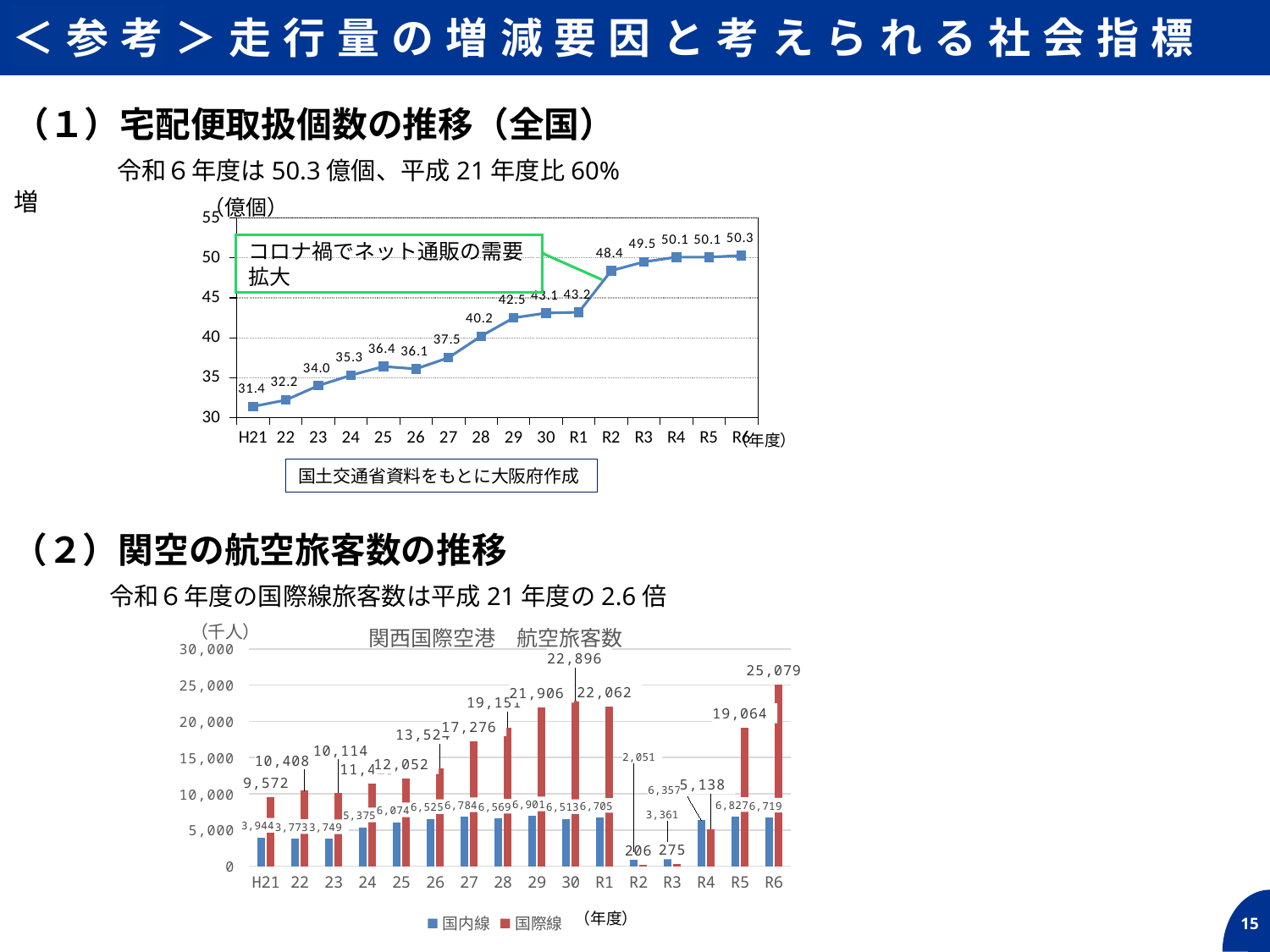
In the top chart (宅配便取扱個数の推移), which year has the lowest value? H21 In the bottom chart (関西国際空港 航空旅客数), what is the 国際線 value for R6? 25,079 In the bottom chart (関西国際空港 航空旅客数), how many series does the legend list? 2 In the top chart (宅配便取扱個数の推移), what is the value for H21? 31.4 In the top chart (宅配便取扱個数の推移), what is the difference between the values for R2 and R1? 5.2 In the top chart (宅配便取扱個数の推移), what is the value for R2? 48.4 In the bottom chart (関西国際空港 航空旅客数), what is the 国内線 value for H21? 3,944 In the top chart (宅配便取扱個数の推移), do the values generally rise or fall from H21 to R6? Rise In the top chart (宅配便取扱個数の推移), what kind of chart is shown? Line chart In the bottom chart (関西国際空港 航空旅客数), which year has the highest 国際線 value? R6 In the bottom chart (関西国際空港 航空旅客数), is the 国際線 value for R5 greater or less than 15,000? greater In the top chart (宅配便取扱個数の推移), what is the value for R6? 50.3